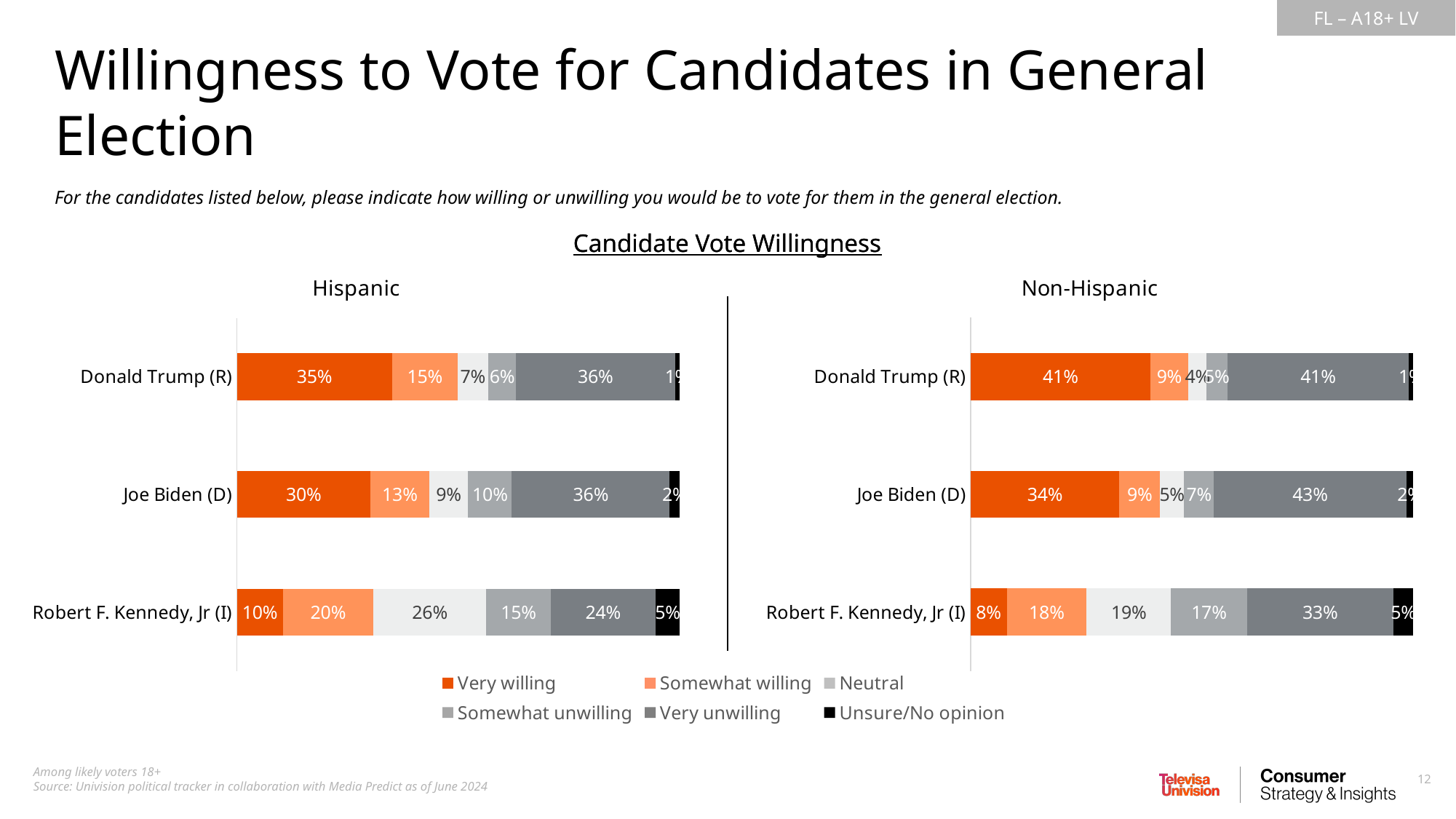
In the Hispanic chart, what percentage of respondents are very willing to vote for Donald Trump (R)? 35% In the Non-Hispanic chart, which candidate has the lowest very willing percentage? Robert F. Kennedy, Jr (I) In the Hispanic chart, what is the difference between the very willing percentages for Donald Trump (R) and Joe Biden (D)? 5% In the Hispanic chart, which candidate has the highest very willing percentage? Donald Trump (R) How many series does the legend list? 6 In the Non-Hispanic chart, what percentage of respondents are very unwilling to vote for Joe Biden (D)? 43% How many candidates are shown in the Hispanic chart? 3 In the Non-Hispanic chart, is the very unwilling percentage larger for Joe Biden (D) or Robert F. Kennedy, Jr (I)? Joe Biden (D) What is the title shown above the two charts? Candidate Vote Willingness In the Hispanic chart, what percentage of respondents are neutral about Robert F. Kennedy, Jr (I)? 26% In the Non-Hispanic chart, what percentage of respondents are somewhat willing to vote for Robert F. Kennedy, Jr (I)? 18% What kind of chart is used for the Non-Hispanic data? Stacked bar chart